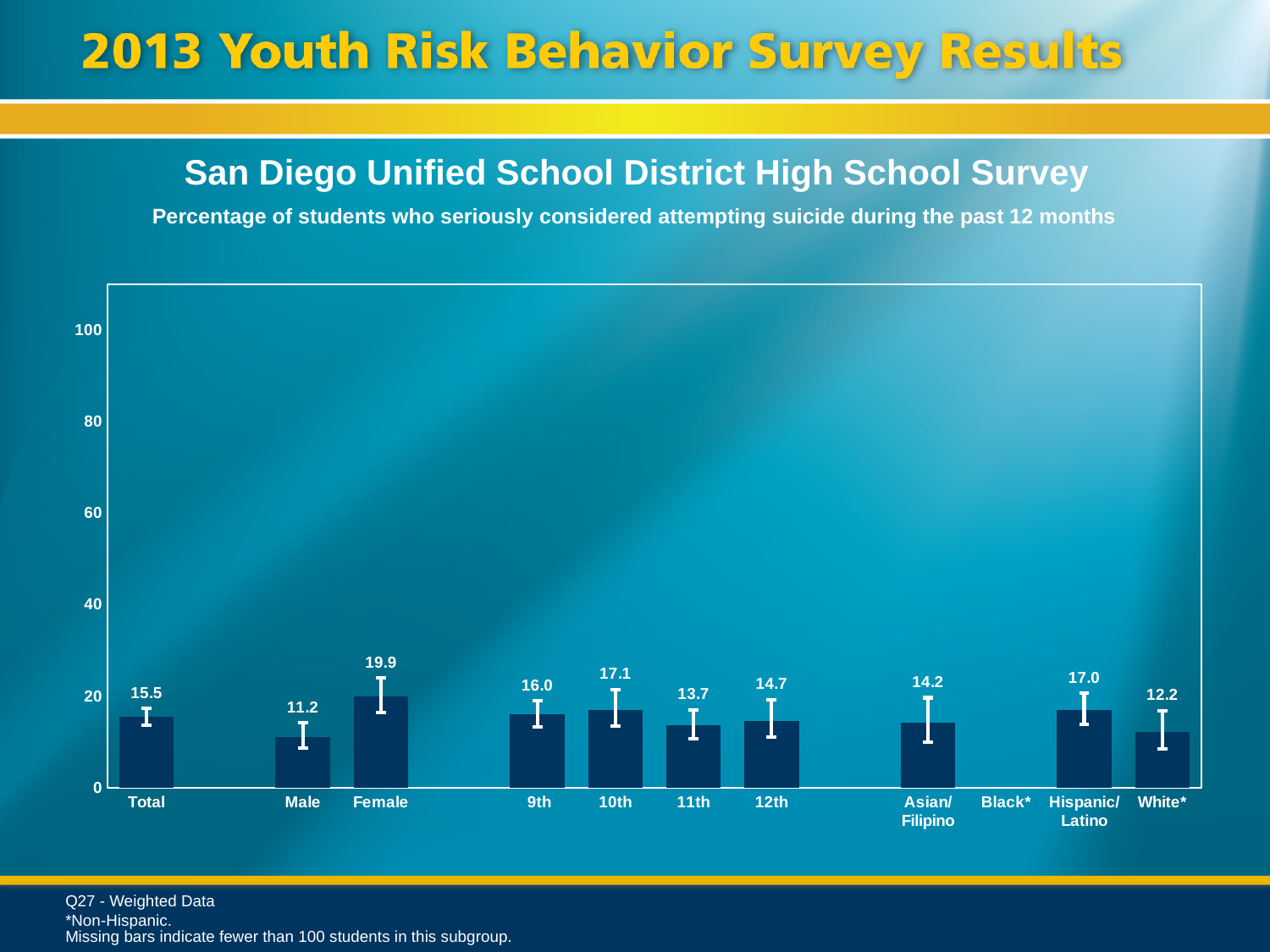
What is the value for Hispanic/Latino? 17.0 Which category has the highest value? Female Is the value for Asian/Filipino greater or less than 20? less What is the value for Total? 15.5 Which category with a plotted bar has the lowest value? Male What is the difference between the Female and Male values? 8.7 What is the value for Female? 19.9 What kind of chart is shown? bar chart Which category has no bar shown? Black* What is the value for 11th grade? 13.7 Which is larger, the value for 10th grade or the value for 12th grade? 10th How many categories have a plotted bar? 10